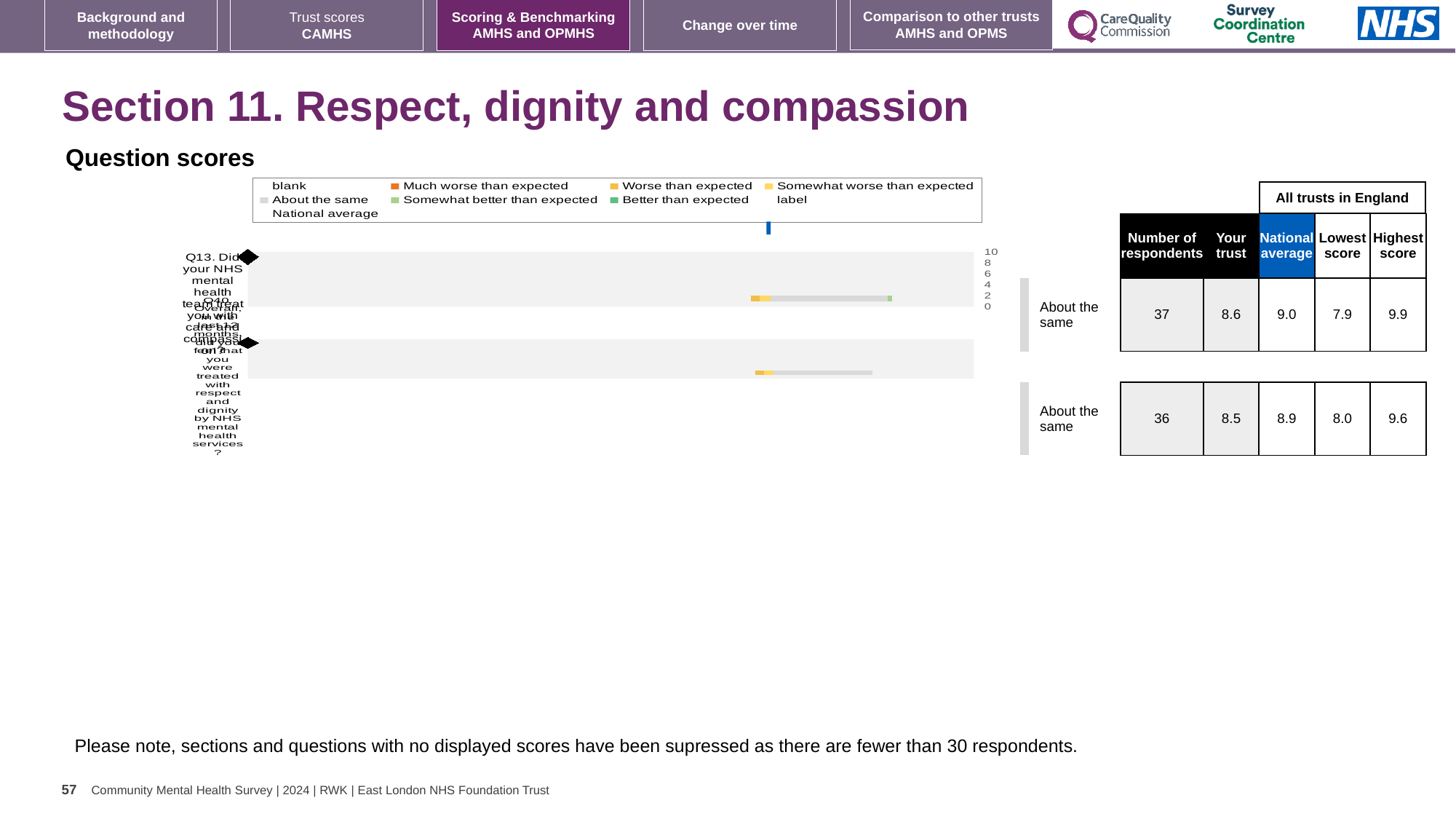
What is the highest value shown on the axis of the Question scores chart? 10 In the legend of the Question scores chart, what colour represents 'Much worse than expected'? Orange What benchmark category is shown next to both questions in the Question scores chart? About the same In the table beside the Question scores chart, what is the 'Your trust' score for the first row (Q13)? 8.6 In the table beside the Question scores chart, what is the 'Your trust' score for the second row (Q10)? 8.5 How many questions (categories) are plotted in the Question scores chart? 2 In the table beside the Question scores chart, what is the number of respondents for the first row (Q13)? 37 In the table beside the Question scores chart, what is the national average for the second row (Q10)? 8.9 What kind of chart is shown under 'Question scores'? Bar chart How many entries does the legend of the Question scores chart list? 9 In the table beside the Question scores chart, which row has the higher 'Highest score', the first row (Q13) or the second row (Q10)? The first row (Q13) In the legend of the Question scores chart, what colour represents 'Better than expected'? Green